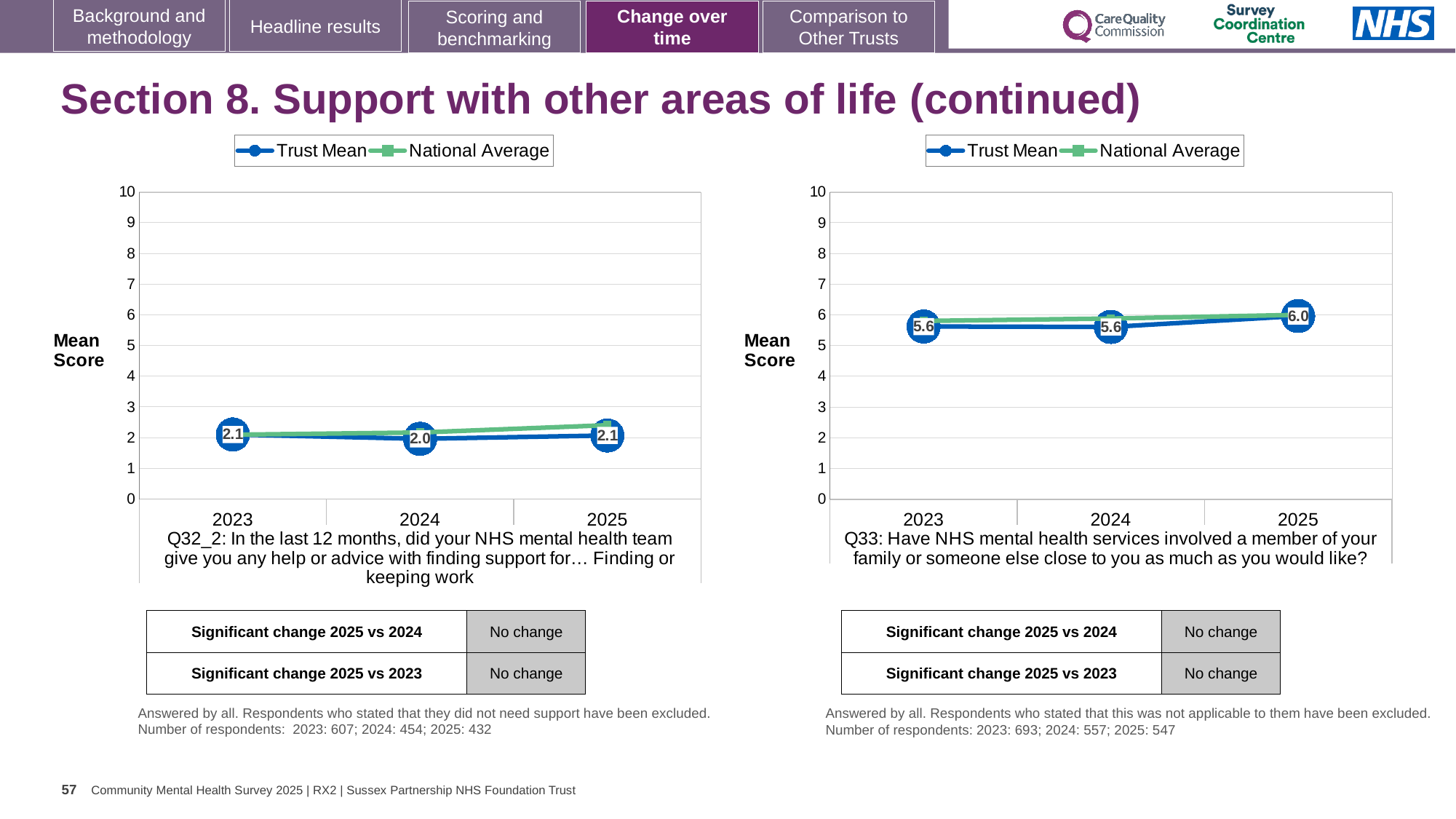
On the right chart (Q33), which year has the highest Trust Mean score? 2025 On the left chart (Q32_2), what is the Trust Mean score for 2025? 2.1 On the left chart (Q32_2), which year has the lowest Trust Mean score? 2024 On the left chart (Q32_2), is the Trust Mean score for 2025 larger or smaller than for 2024? larger On the left chart (Q32_2), what is the Trust Mean score for 2024? 2.0 On the right chart (Q33), what is the Trust Mean score for 2025? 6.0 How many series does the legend of the right chart (Q33) list? 2 On the right chart (Q33), is the National Average value for 2025 greater or less than 5? greater On the right chart (Q33), what is the Trust Mean score for 2023? 5.6 How many years are plotted on the left chart (Q32_2)? 3 What kind of chart is used for Q33 on the right of the slide? Line chart On the right chart (Q33), what is the difference between the Trust Mean scores for 2025 and 2023? 0.4